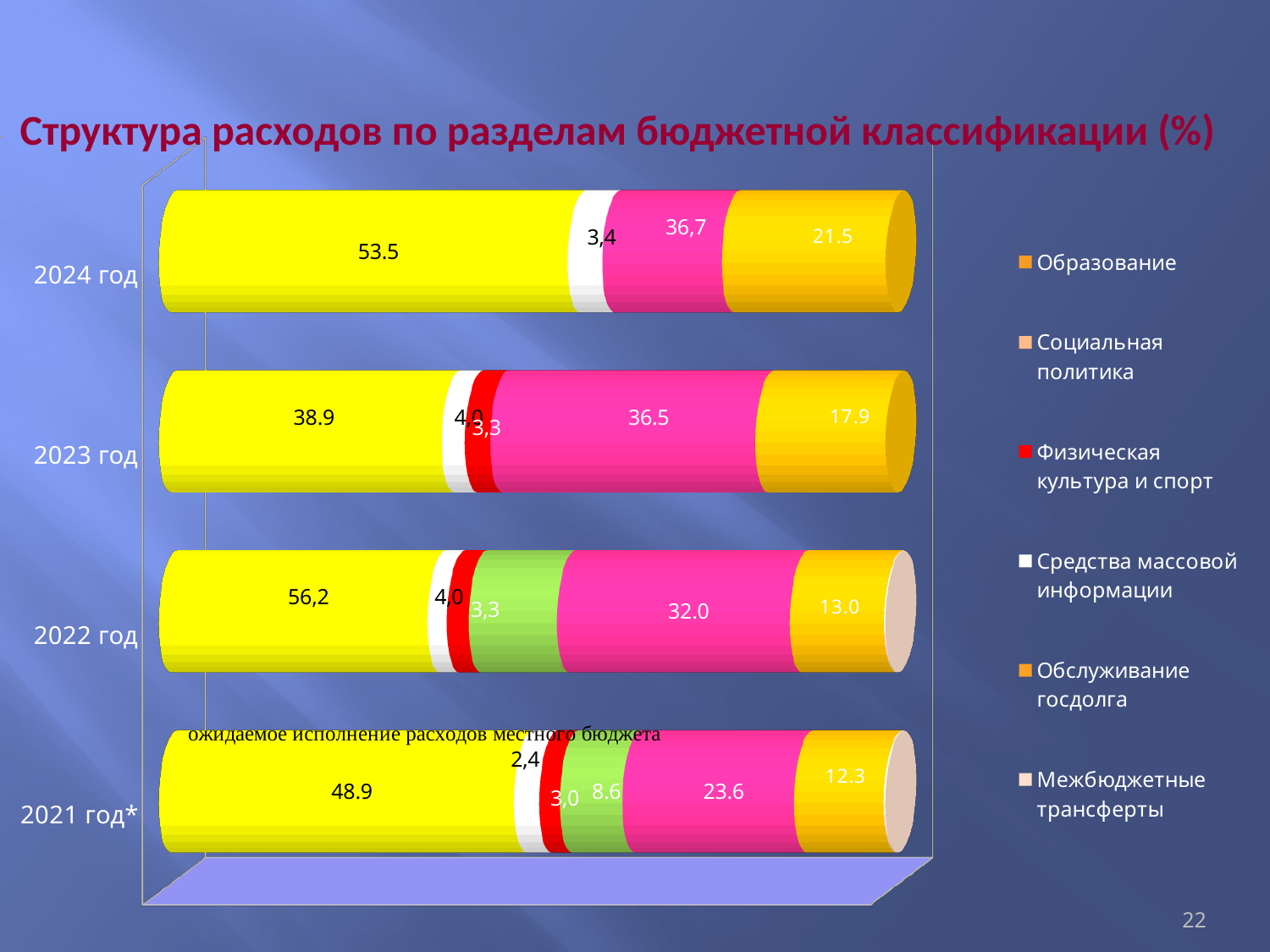
How many series does the legend list? 6 How many years (categories) are shown on the chart? 4 What is the value labeled on the green segment of the 2021 год* bar? 8.6 What is the difference between the yellow segment values for 2024 год (53.5) and 2023 год (38.9)? 14.6 Which is larger: the pink segment value for 2024 год or for 2022 год? 2024 год What is the value labeled on the gold segment at the right end of the 2022 год bar? 13.0 Which year has the largest value on its yellow segment? 2022 год What is the value labeled on the yellow segment of the 2024 год bar? 53.5 Which year has the smallest value on its gold (right-end) segment? 2021 год* What is the title of the chart? Структура расходов по разделам бюджетной классификации (%) What type of chart is shown on the slide? stacked bar chart What is the value labeled on the pink segment of the 2023 год bar? 36.5